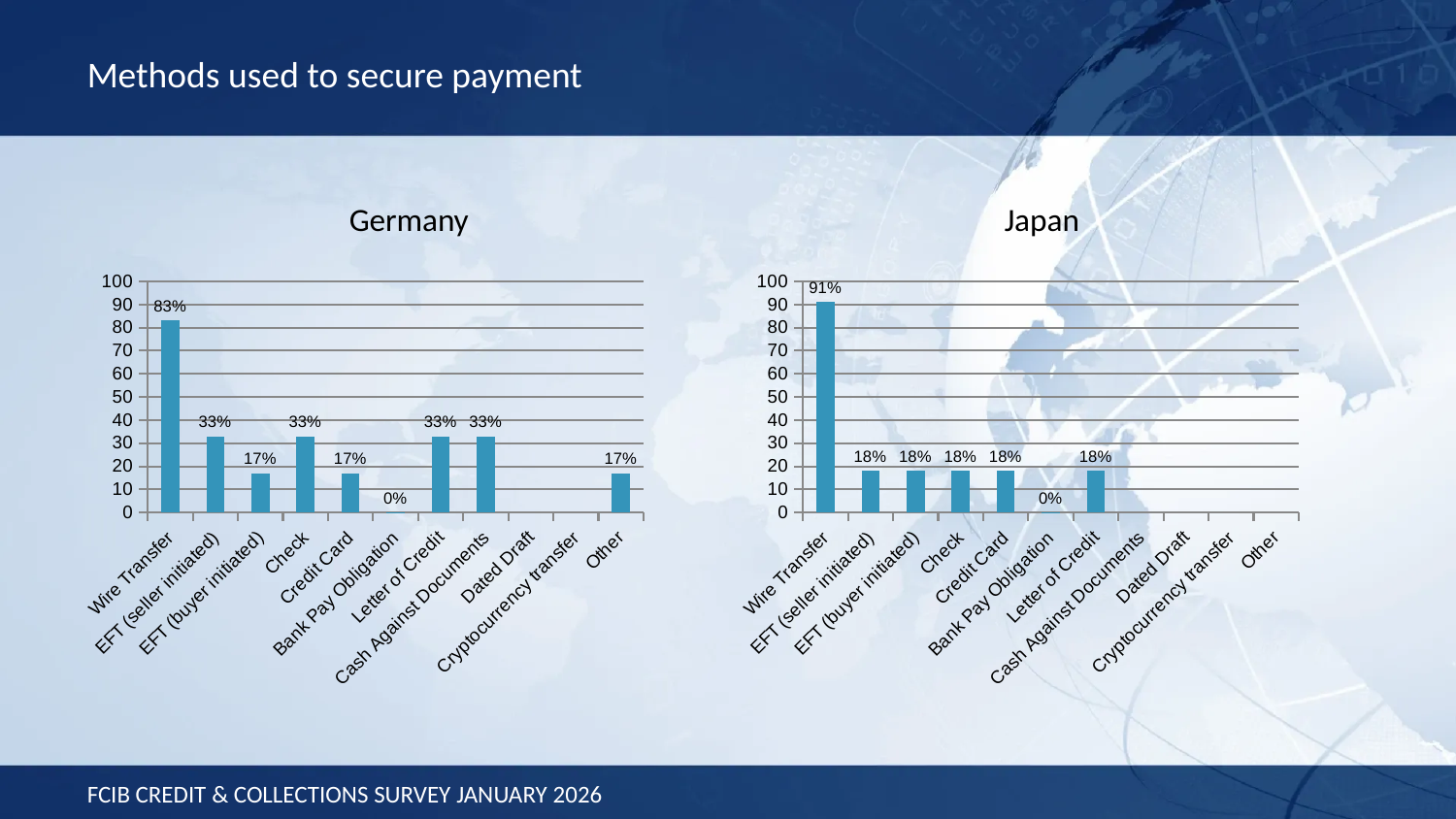
Which chart shows a higher value for Wire Transfer, Germany or Japan? Japan In the Japan chart, which method has the highest value? Wire Transfer What kind of chart is the Japan chart? Bar chart In the Germany chart, which is larger, EFT (seller initiated) or EFT (buyer initiated)? EFT (seller initiated) In the Germany chart, which method has the highest value? Wire Transfer In the Germany chart, what percentage is shown for Bank Pay Obligation? 0% In the Germany chart, what is the difference between the Wire Transfer value and the Check value? 50 percentage points In the Japan chart, what percentage is shown for Credit Card? 18% How many categories are listed on the x axis of the Germany chart? 11 In the Japan chart, what percentage is shown for Letter of Credit? 18% In the Japan chart, what percentage is shown for Wire Transfer? 91% In the Germany chart, what percentage is shown for Wire Transfer? 83%